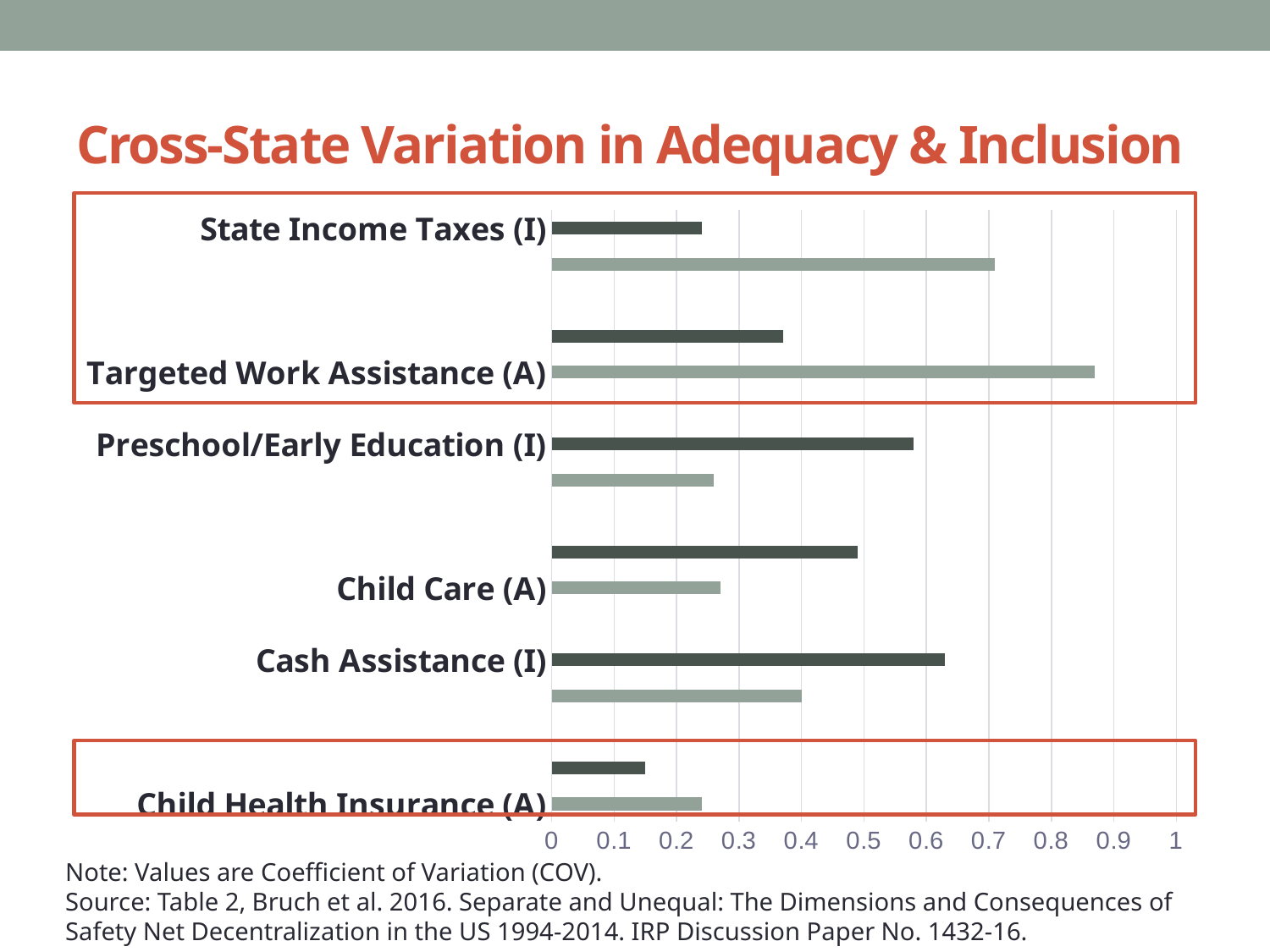
For State Income Taxes (I), which bar is longer, the dark one or the light one? The light one What kind of chart is shown on the slide? Bar chart Which category has the shortest dark-coloured bar? Child Health Insurance (A) What is the title of the slide? Cross-State Variation in Adequacy & Inclusion According to the note below the chart, what do the plotted values represent? Coefficient of Variation (COV) For Cash Assistance (I), which bar is longer, the dark one or the light one? The dark one Which category has the longest light-coloured bar? Targeted Work Assistance (A) Is the light-coloured bar for Child Care (A) greater or less than 0.4? less Is the dark-coloured bar for Child Health Insurance (A) greater or less than 0.2? less Is the dark-coloured bar for Preschool/Early Education (I) greater or less than 0.5? greater How many categories are listed on the vertical axis of the chart? 6